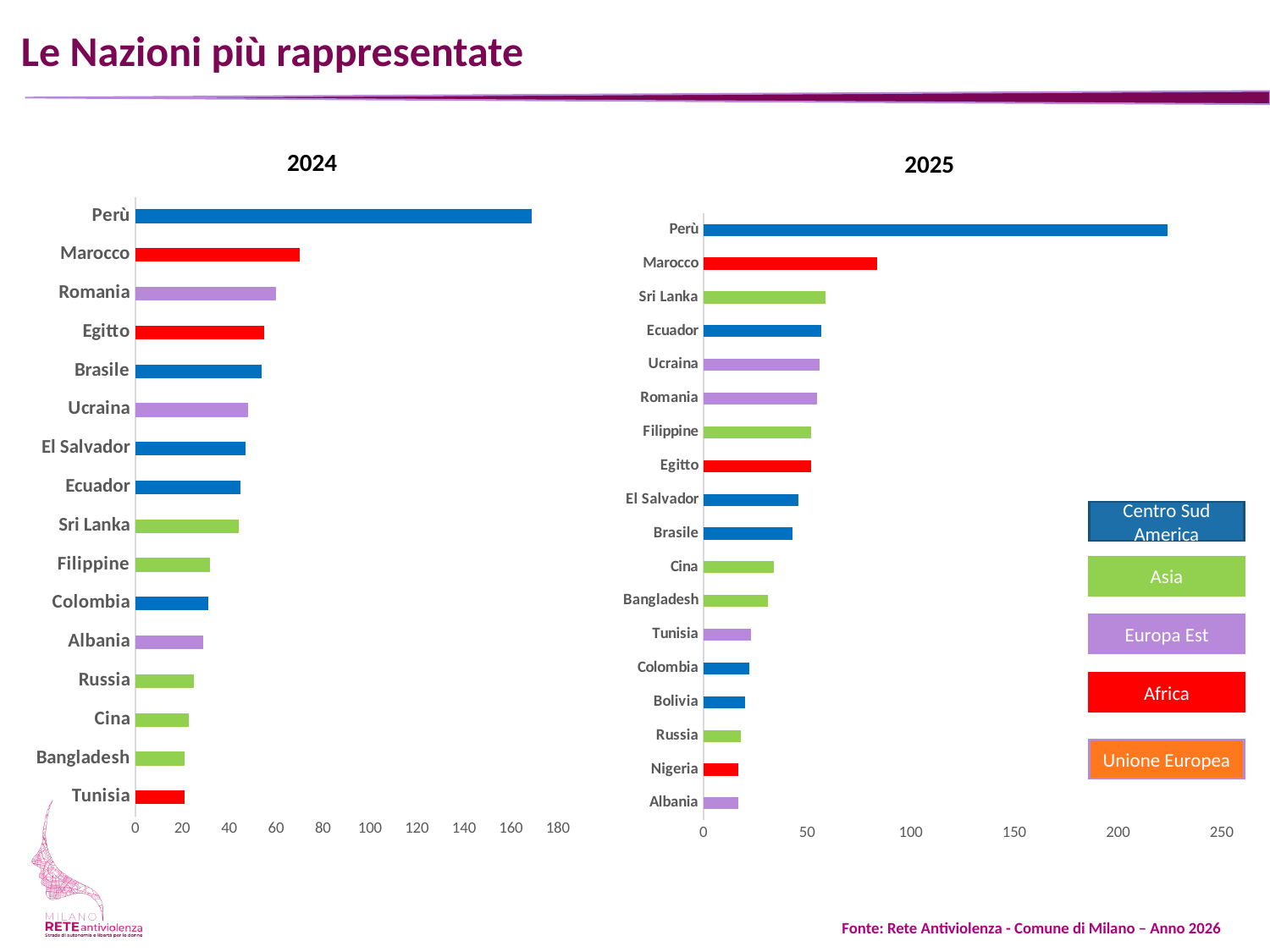
In the 2024 chart, which is larger, the value for Marocco or the value for Romania? Marocco How many nations are shown in the 2024 chart? 16 How many nations are shown in the 2025 chart? 18 What kind of chart is the 2024 chart? bar chart In the 2025 chart, which is larger, the value for Marocco or the value for Sri Lanka? Marocco How many regions does the legend on the slide list? 5 In the 2024 chart, is the value for Perù greater or less than 160? greater In the 2025 chart, is the value for Perù greater or less than 200? greater In the 2024 chart, is the value for Egitto greater or less than 60? less In the 2025 chart, which nation has the highest value? Perù In the 2024 chart, which nation has the highest value? Perù